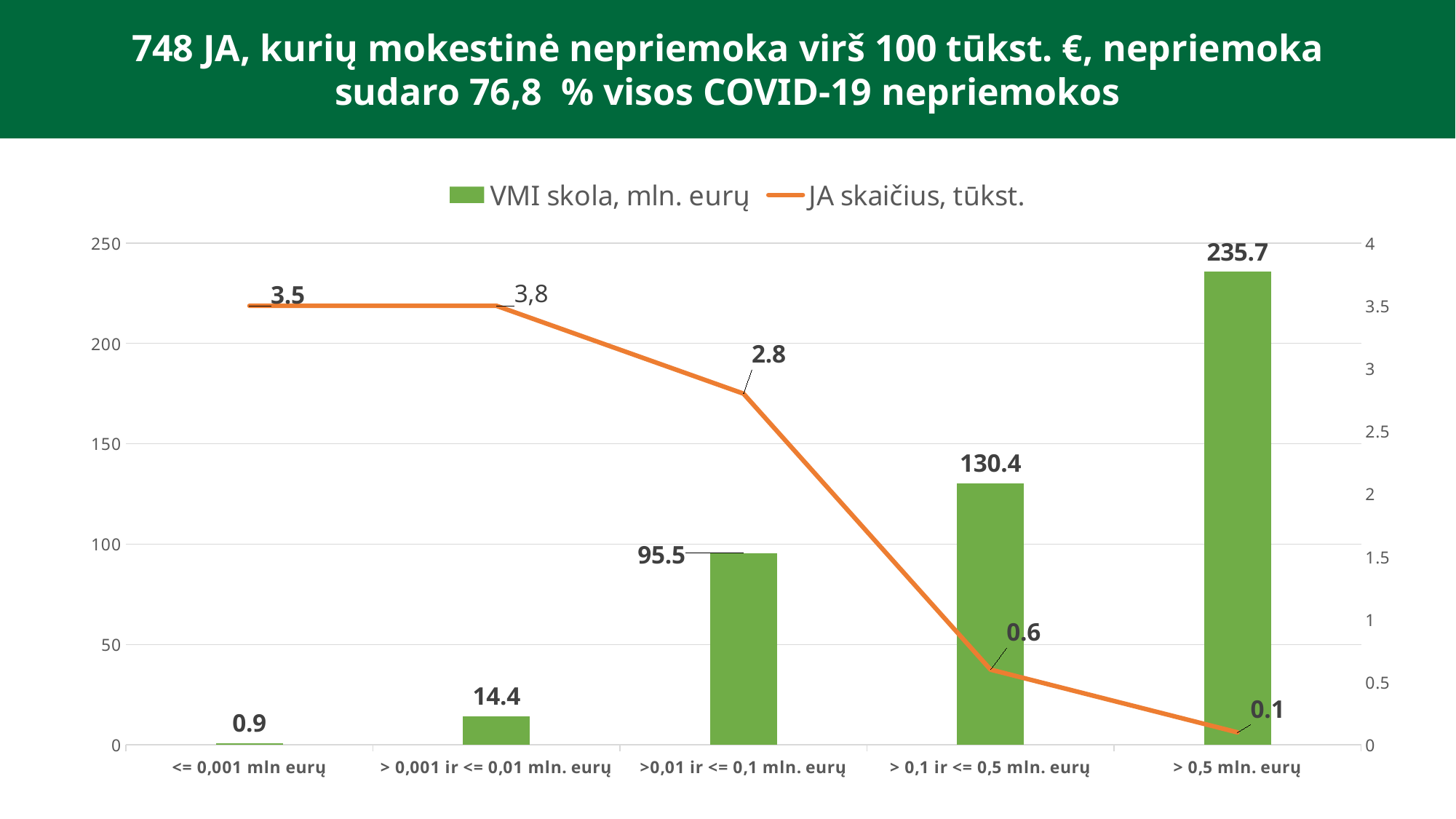
What is the difference between the VMI skola, mln. eurų values for "> 0,5 mln. eurų" and "> 0,1 ir <= 0,5 mln. eurų"? 105.3 What colour are the VMI skola, mln. eurų bars? green What is the JA skaičius, tūkst. value for the category "> 0,1 ir <= 0,5 mln. eurų"? 0.6 Which category has the highest VMI skola, mln. eurų value? > 0,5 mln. eurų Which category has the lowest JA skaičius, tūkst. value? > 0,5 mln. eurų What is the VMI skola, mln. eurų value for the category ">0,01 ir <= 0,1 mln. eurų"? 95.5 What is the VMI skola, mln. eurų value for the category "> 0,5 mln. eurų"? 235.7 Which is larger, the VMI skola, mln. eurų value for "> 0,001 ir <= 0,01 mln. eurų" or for ">0,01 ir <= 0,1 mln. eurų"? >0,01 ir <= 0,1 mln. eurų Does the JA skaičius, tūkst. line rise or fall from ">0,01 ir <= 0,1 mln. eurų" to "> 0,5 mln. eurų"? fall What is the JA skaičius, tūkst. value for the category "> 0,001 ir <= 0,01 mln. eurų"? 3,8 How many series does the legend list? 2 How many categories are shown on the x axis? 5